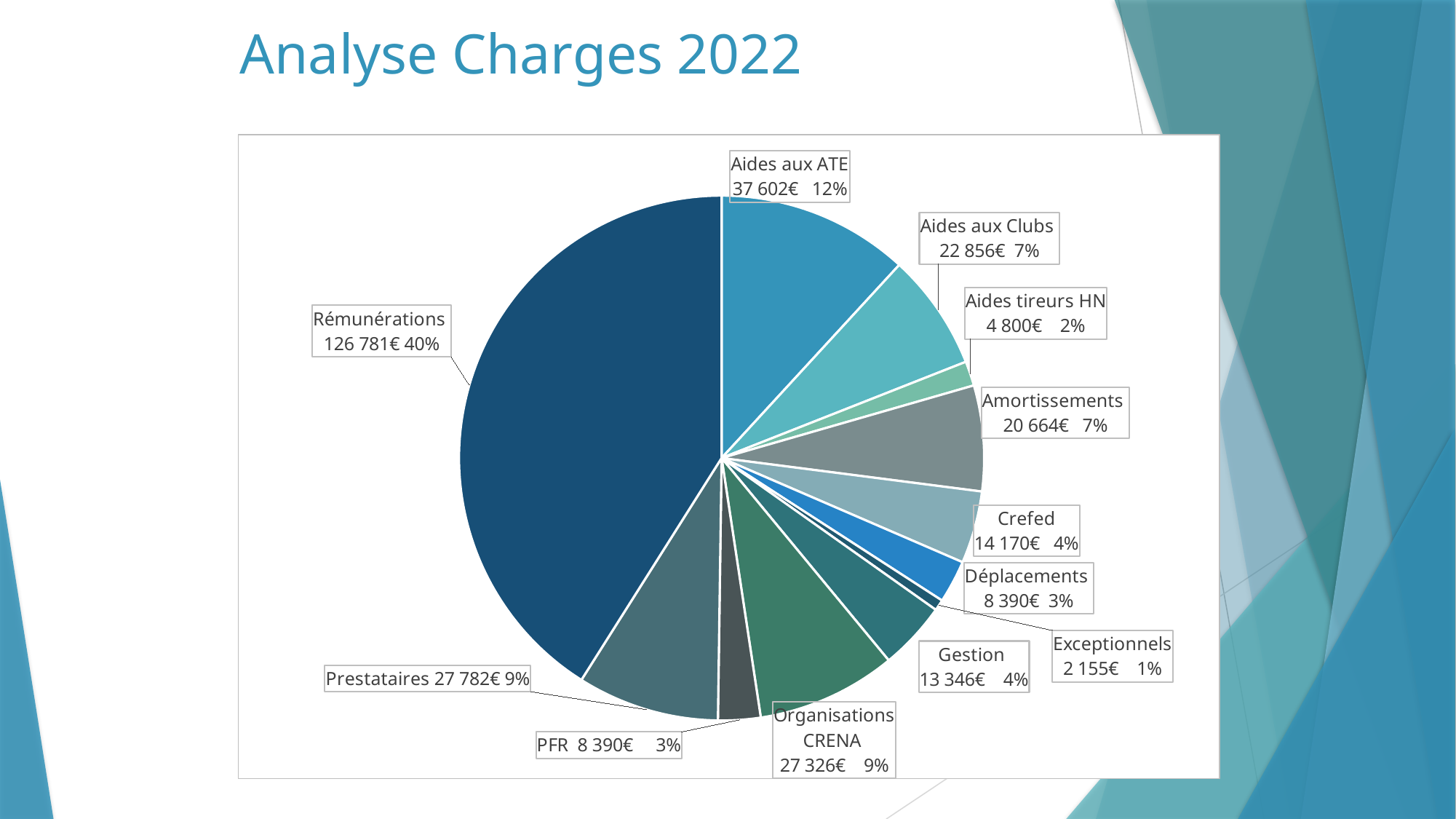
What is the value for Exceptionnels? 2 155€ What is the difference between the values for Prestataires and Organisations CRENA? 456€ What kind of chart is shown on the slide? pie chart What share of the pie does Crefed represent? 4% What is the value for Rémunérations? 126 781€ Which is larger, the value for Amortissements or the value for Aides aux Clubs? Aides aux Clubs Which category has the largest slice of the pie? Rémunérations What is the value for Organisations CRENA? 27 326€ How many categories are shown in the pie chart? 12 What share of the pie does Aides aux Clubs represent? 7% What is the value for Aides aux ATE? 37 602€ Which category has the smallest slice of the pie? Exceptionnels